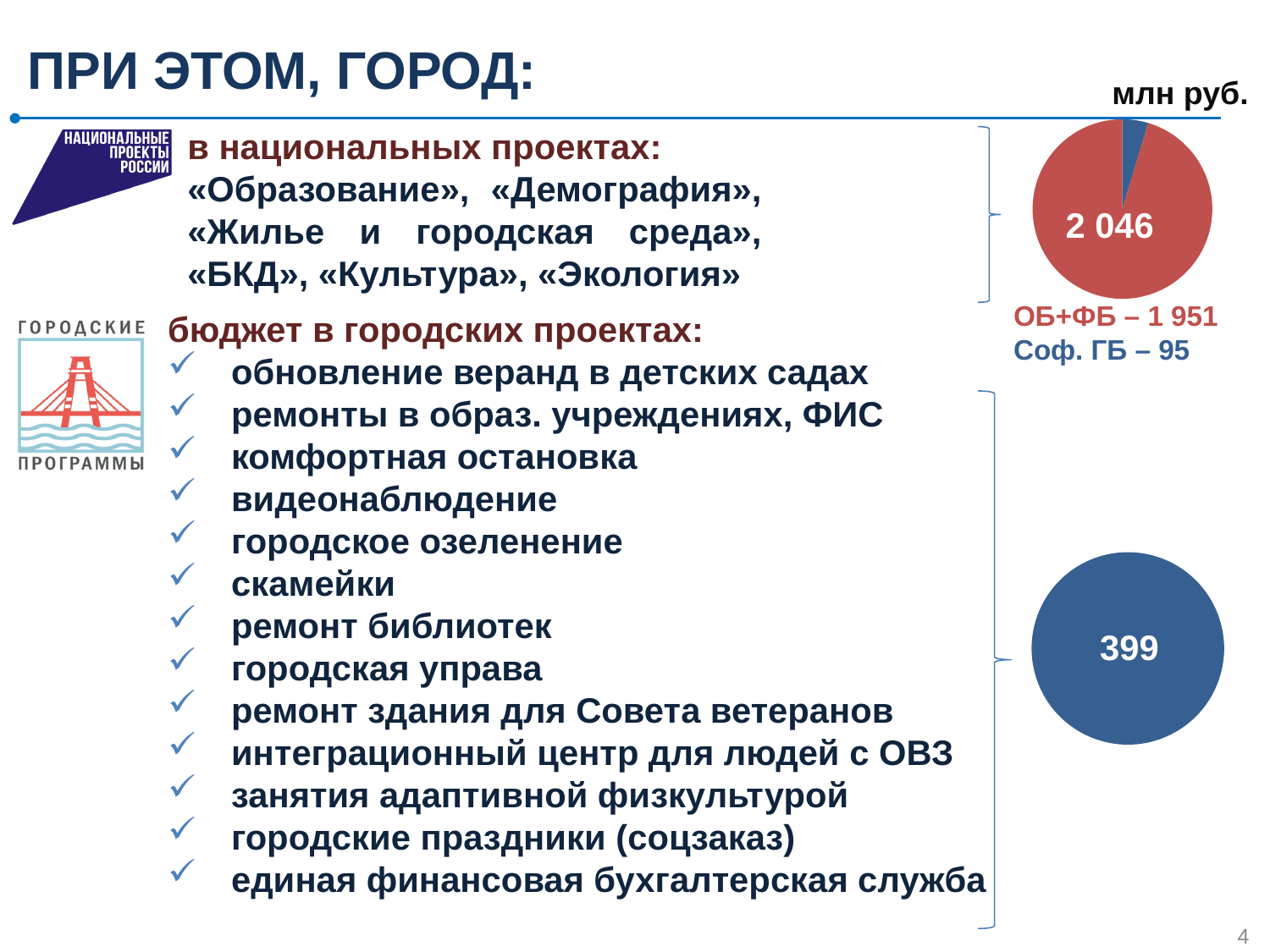
In the upper pie chart, what is the value for ОБ+ФБ? 1 951 In the upper pie chart, which slice is larger, ОБ+ФБ or Соф. ГБ? ОБ+ФБ What total value is printed in the centre of the upper pie chart? 2 046 In the upper pie chart, which slice is the smallest? Соф. ГБ What colour is the ОБ+ФБ slice in the upper pie chart? red What kind of chart is the upper chart on the right side of the slide? pie chart How many slices does the upper pie chart have? 2 What unit is indicated for the values in the charts on the slide? млн руб. In the upper pie chart, what is the value for Соф. ГБ? 95 Which chart shows the larger value, the upper pie chart (2 046) or the lower pie chart (399)? the upper pie chart What value is printed in the centre of the lower pie chart? 399 In the upper pie chart, what is the difference between ОБ+ФБ and Соф. ГБ? 1 856